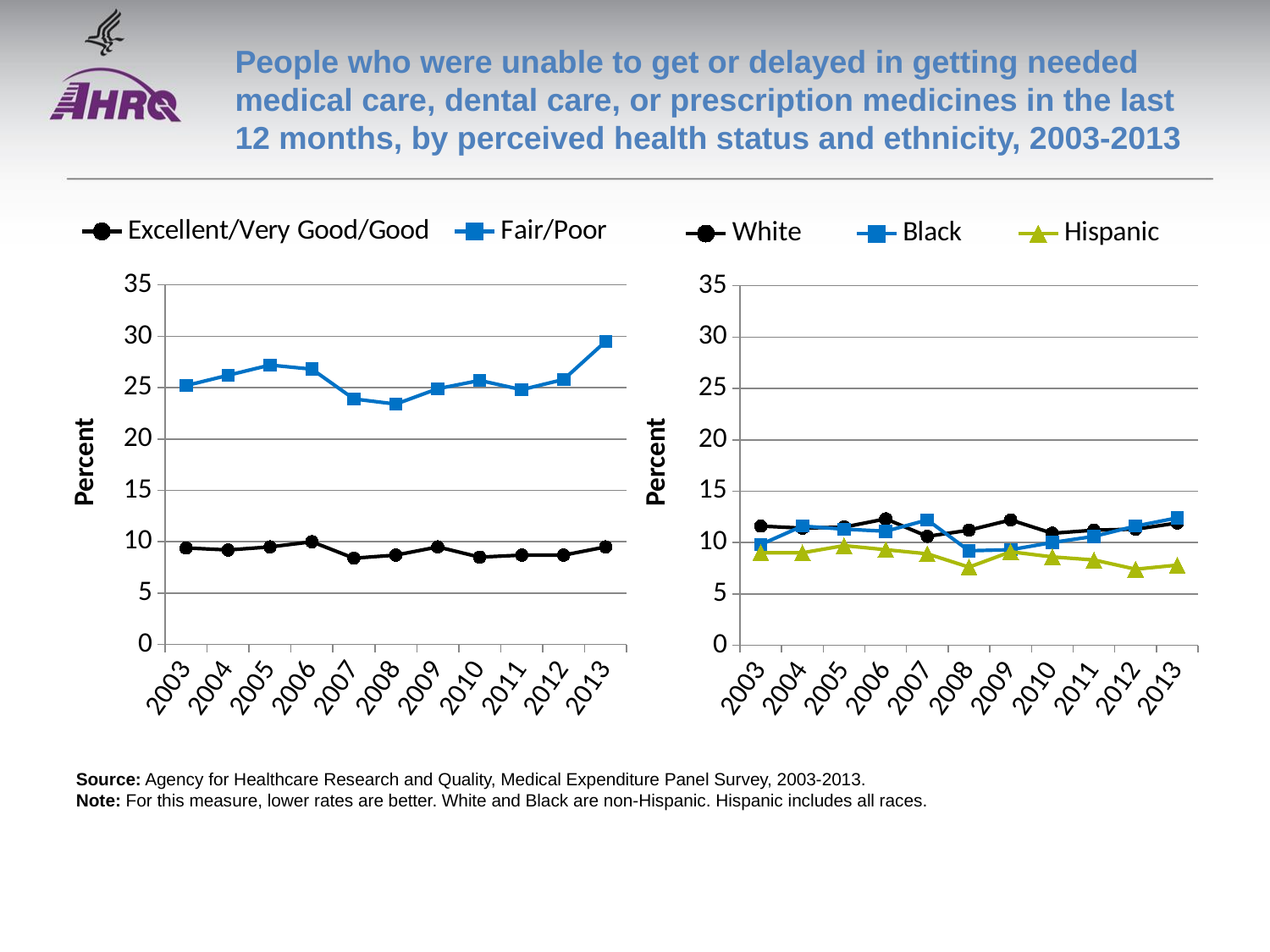
How many series does the legend of the right chart list? 3 In the left chart, is the Fair/Poor value for 2013 greater or less than 25? greater In the right chart, is the Hispanic value for 2012 greater or less than 10? less In the left chart, does the Fair/Poor value rise or fall from 2012 to 2013? rise In the left chart, is the Fair/Poor value for 2008 greater or less than 25? less How many years are shown on the x axis of the left chart? 11 In the left chart, in which year is the Fair/Poor value highest? 2013 In the right chart, which is larger in 2013, the Black value or the Hispanic value? Black How many series does the legend of the left chart list? 2 What is the label on the y axis of the right chart? Percent What kind of chart is the left chart on the slide? line chart